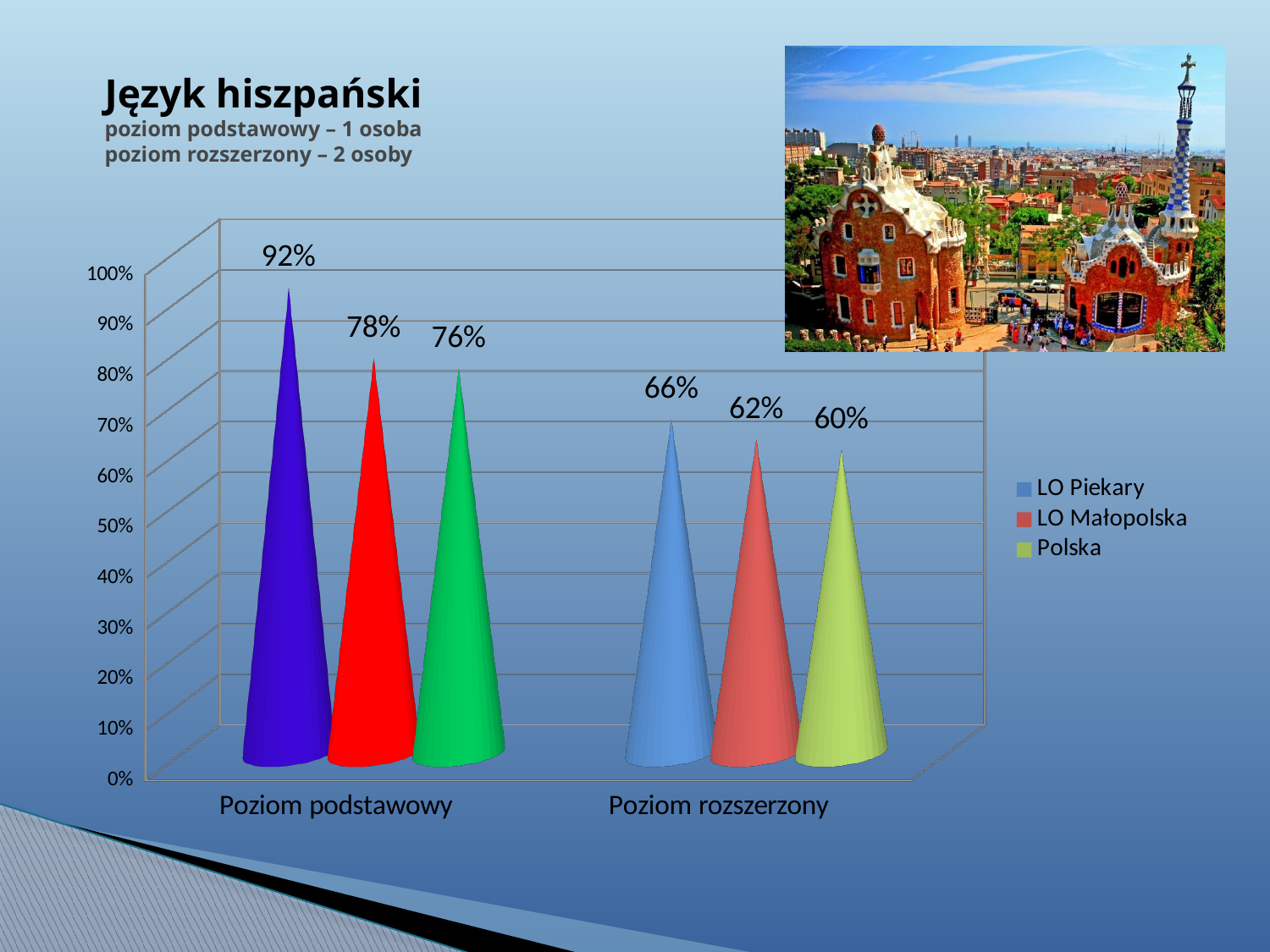
What is the value for Polska at Poziom rozszerzony? 60% How many categories are shown on the x axis? 2 Which series has the lowest value at Poziom rozszerzony? Polska What is the difference between LO Piekary's values at Poziom podstawowy and Poziom rozszerzony? 26% How many series does the legend list? 3 Do the values for Polska rise or fall from Poziom podstawowy to Poziom rozszerzony? Fall What is the value for LO Małopolska at Poziom rozszerzony? 62% What kind of chart is shown on the slide? Bar chart What is the difference between LO Piekary and Polska at Poziom podstawowy? 16% Which series has the highest value at Poziom podstawowy? LO Piekary Which is larger: LO Małopolska at Poziom podstawowy or LO Piekary at Poziom rozszerzony? LO Małopolska at Poziom podstawowy What is the value for LO Piekary at Poziom podstawowy? 92%